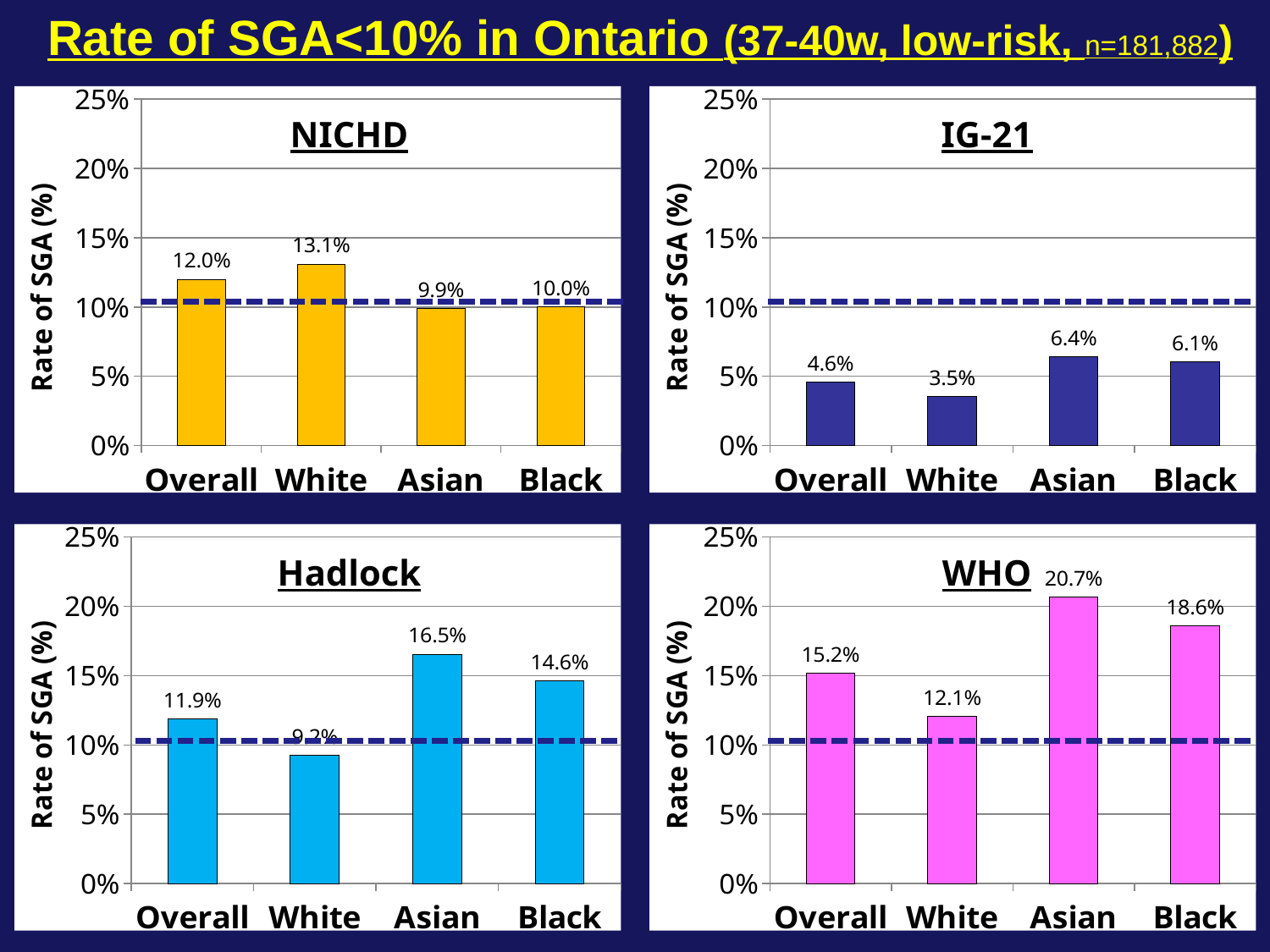
In the IG-21 chart, which category has the lowest rate of SGA? White In the Hadlock chart, what is the rate of SGA for Overall? 11.9% In the Hadlock chart, what is the difference between the Asian and White rates of SGA? 7.3% In the IG-21 chart, what is the rate of SGA for Asian? 6.4% In the IG-21 chart, is the value for Overall greater or less than 10%? less What is the y-axis label on the NICHD chart? Rate of SGA (%) In the WHO chart, which category has the highest rate of SGA? Asian In the NICHD chart, what is the rate of SGA for White? 13.1% What kind of chart is the WHO chart? bar chart In the NICHD chart, which is larger, the rate for Overall or the rate for Asian? Overall How many categories are shown on the x axis of the Hadlock chart? 4 In the WHO chart, what is the rate of SGA for Black? 18.6%